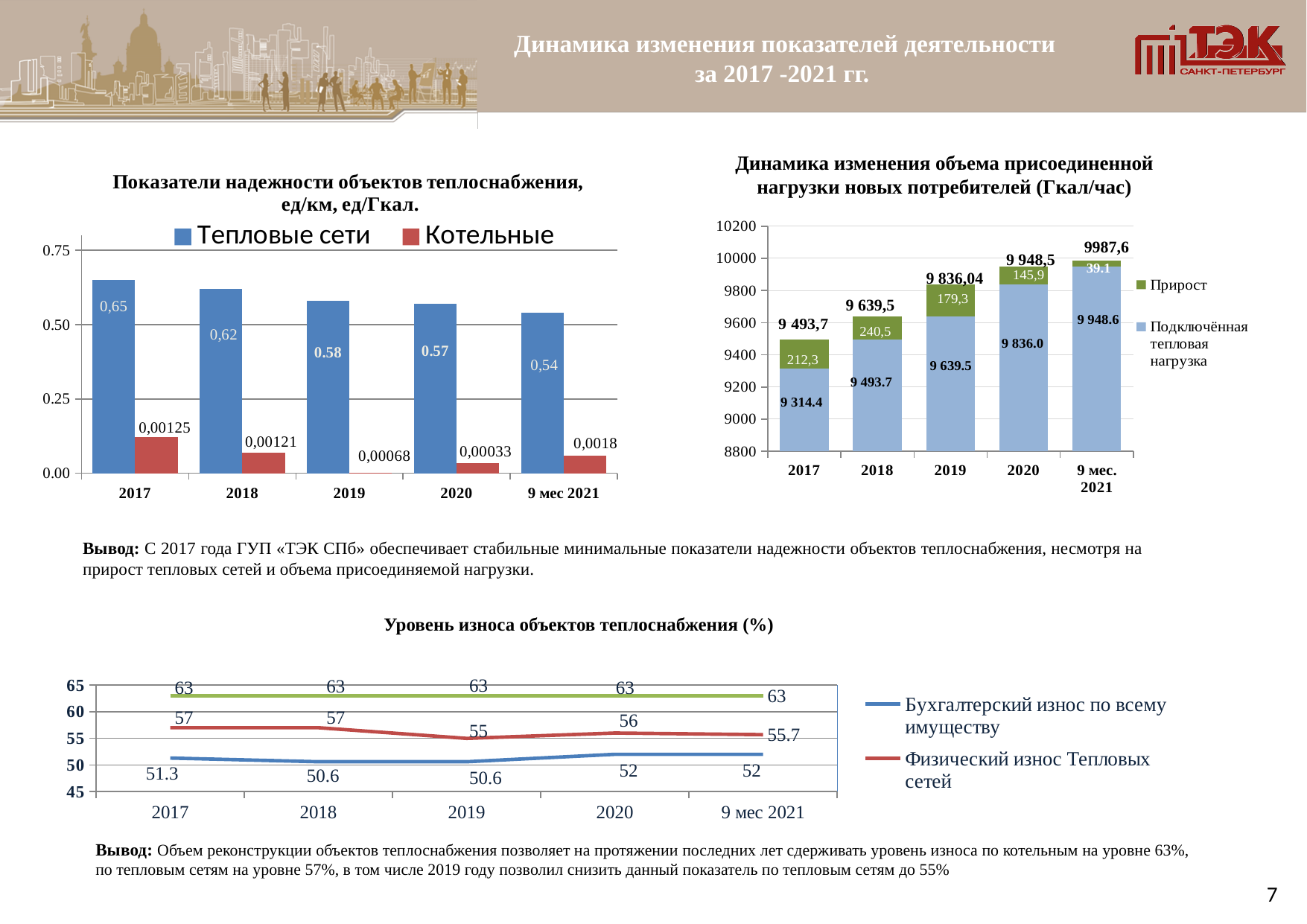
In the chart 'Уровень износа объектов теплоснабжения (%)', what is the difference between Физический износ Тепловых сетей and Бухгалтерский износ по всему имуществу in 2020? 4 In the chart 'Динамика изменения объема присоединенной нагрузки новых потребителей', which year has the highest Прирост value? 2018 In the chart 'Динамика изменения объема присоединенной нагрузки новых потребителей', what is the Прирост value for 2018? 240,5 In the chart 'Динамика изменения объема присоединенной нагрузки новых потребителей', what kind of chart is it? stacked bar chart In the chart 'Динамика изменения объема присоединенной нагрузки новых потребителей', what is the total of the stacked bar for 2020? 9 948,5 In the chart 'Показатели надежности объектов теплоснабжения', do the values for Тепловые сети rise or fall from 2017 to 9 мес 2021? fall In the chart 'Показатели надежности объектов теплоснабжения', how many series does the legend list? 2 In the chart 'Показатели надежности объектов теплоснабжения', what is the value for Тепловые сети in 2017? 0,65 In the chart 'Уровень износа объектов теплоснабжения (%)', how many categories are on the x axis? 5 In the chart 'Показатели надежности объектов теплоснабжения', what is the value for Котельные in 2020? 0,00033 In the chart 'Показатели надежности объектов теплоснабжения', which year has the lowest value for Тепловые сети? 9 мес 2021 In the chart 'Уровень износа объектов теплоснабжения (%)', what is the value of Физический износ Тепловых сетей in 2019? 55